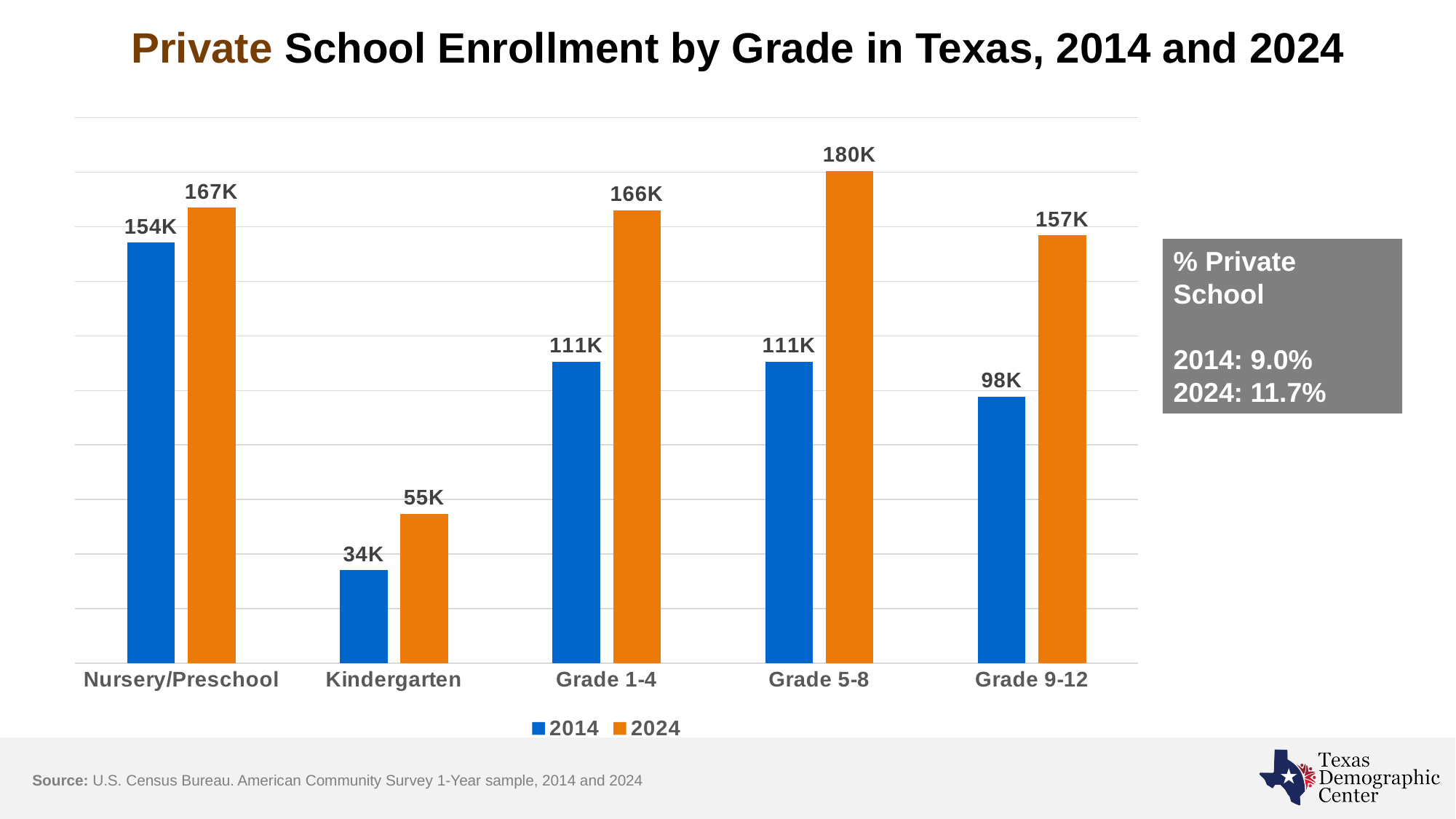
Which was larger: Nursery/Preschool enrollment in 2014 or Grade 9-12 enrollment in 2024? Grade 9-12 enrollment in 2024 What is the difference between 2024 and 2014 private school enrollment for Grade 5-8? 69K What was private school enrollment for Nursery/Preschool in 2024? 167K What was private school enrollment for Grade 5-8 in 2024? 180K What was private school enrollment for Kindergarten in 2014? 34K Which grade category had the highest private school enrollment in 2024? Grade 5-8 How many grade categories are shown on the x axis? 5 According to the text box, what percentage of students were in private school in 2024? 11.7% What is the difference between 2024 and 2014 private school enrollment for Grade 9-12? 59K How many series does the legend list? 2 Which grade category had the lowest private school enrollment in 2014? Kindergarten What kind of chart is shown on the slide? Bar chart